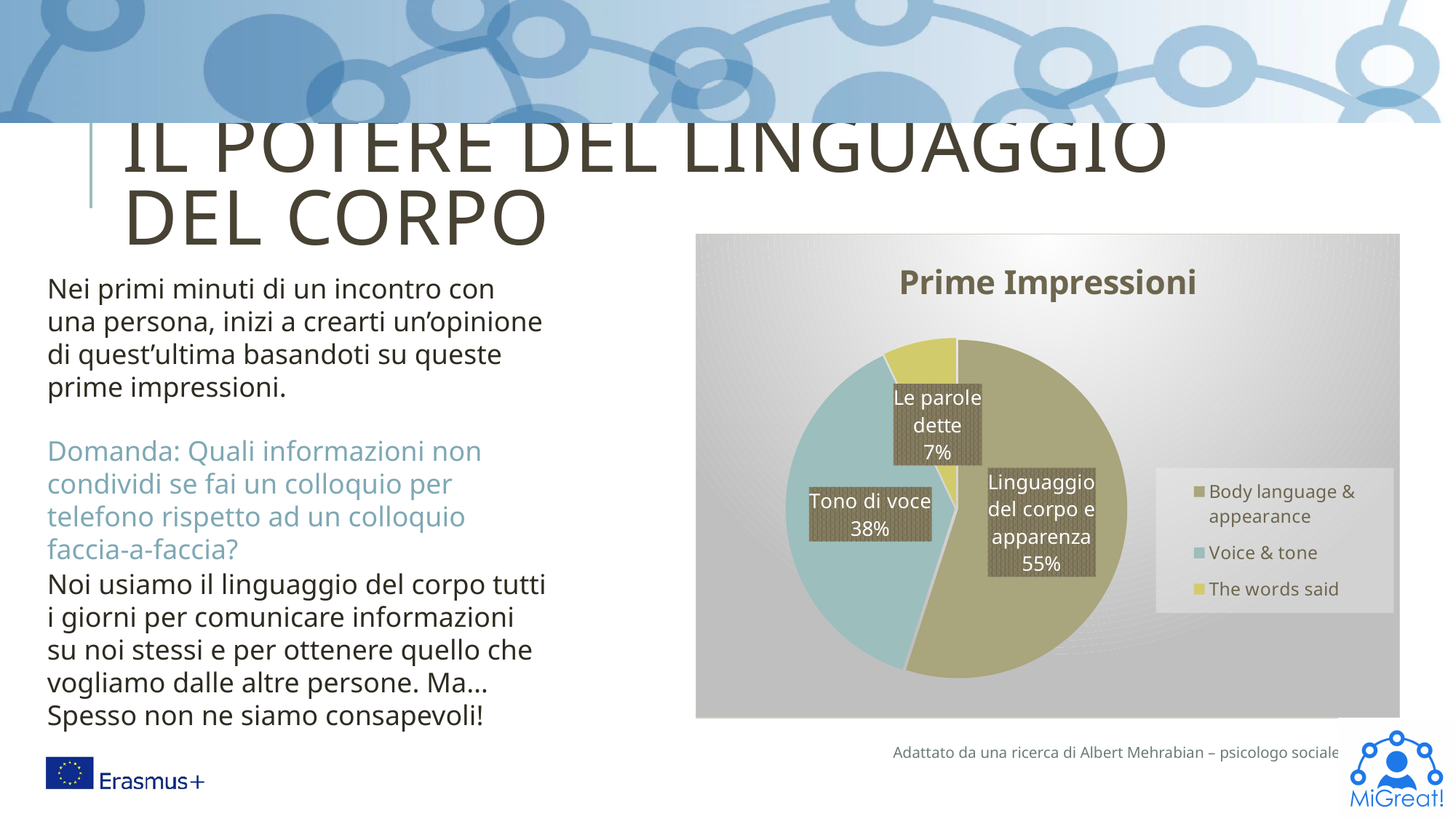
Which slice of the pie is the largest? Linguaggio del corpo e apparenza How many entries does the legend list? 3 How many slices does the pie chart have? 3 What is the title of the chart on the slide? Prime Impressioni What share of the pie does 'Le parole dette' represent? 7% What is the difference between the 'Linguaggio del corpo e apparenza' share and the 'Tono di voce' share? 17% What share of the pie does 'Tono di voce' represent? 38% Which legend entry is shown in yellow? The words said What kind of chart is shown on the slide? pie chart Which slice of the pie is the smallest? Le parole dette What share of the pie does 'Linguaggio del corpo e apparenza' represent? 55% Which is larger, the share for 'Tono di voce' or the share for 'Le parole dette'? Tono di voce